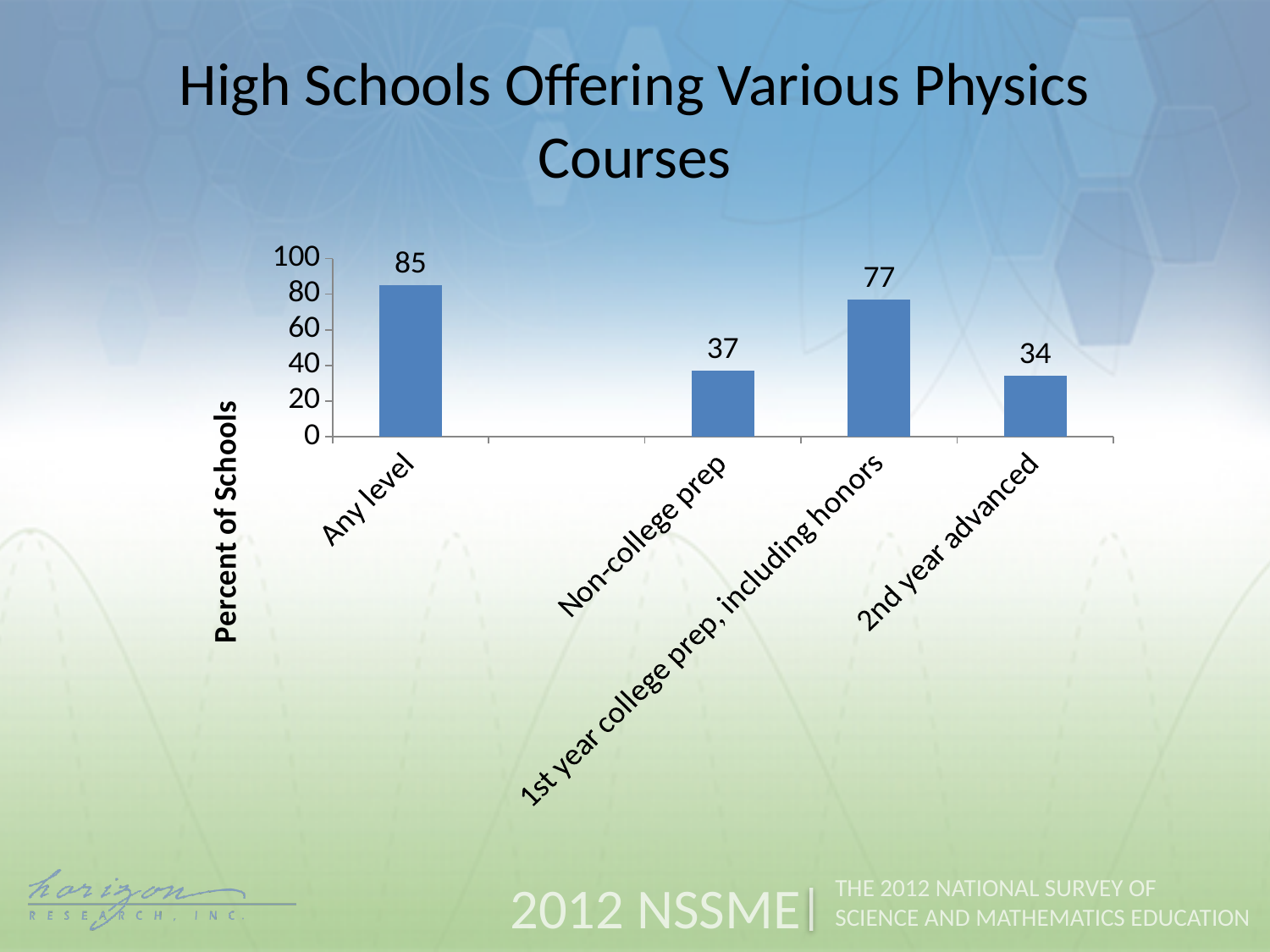
What is the value for 1st year college prep, including honors? 77 Which category has the lowest value? 2nd year advanced How many categories are shown in the chart? 4 What is the label of the vertical axis? Percent of Schools Which category has the highest value? Any level What is the value for Non-college prep? 37 Which is larger, the value for Non-college prep or the value for 1st year college prep, including honors? 1st year college prep, including honors What percent of schools offer physics at any level? 85 What is the difference between the values for Non-college prep and 2nd year advanced? 3 What is the difference between the values for Any level and 1st year college prep, including honors? 8 What kind of chart is shown on the slide? Bar chart What is the value for 2nd year advanced? 34